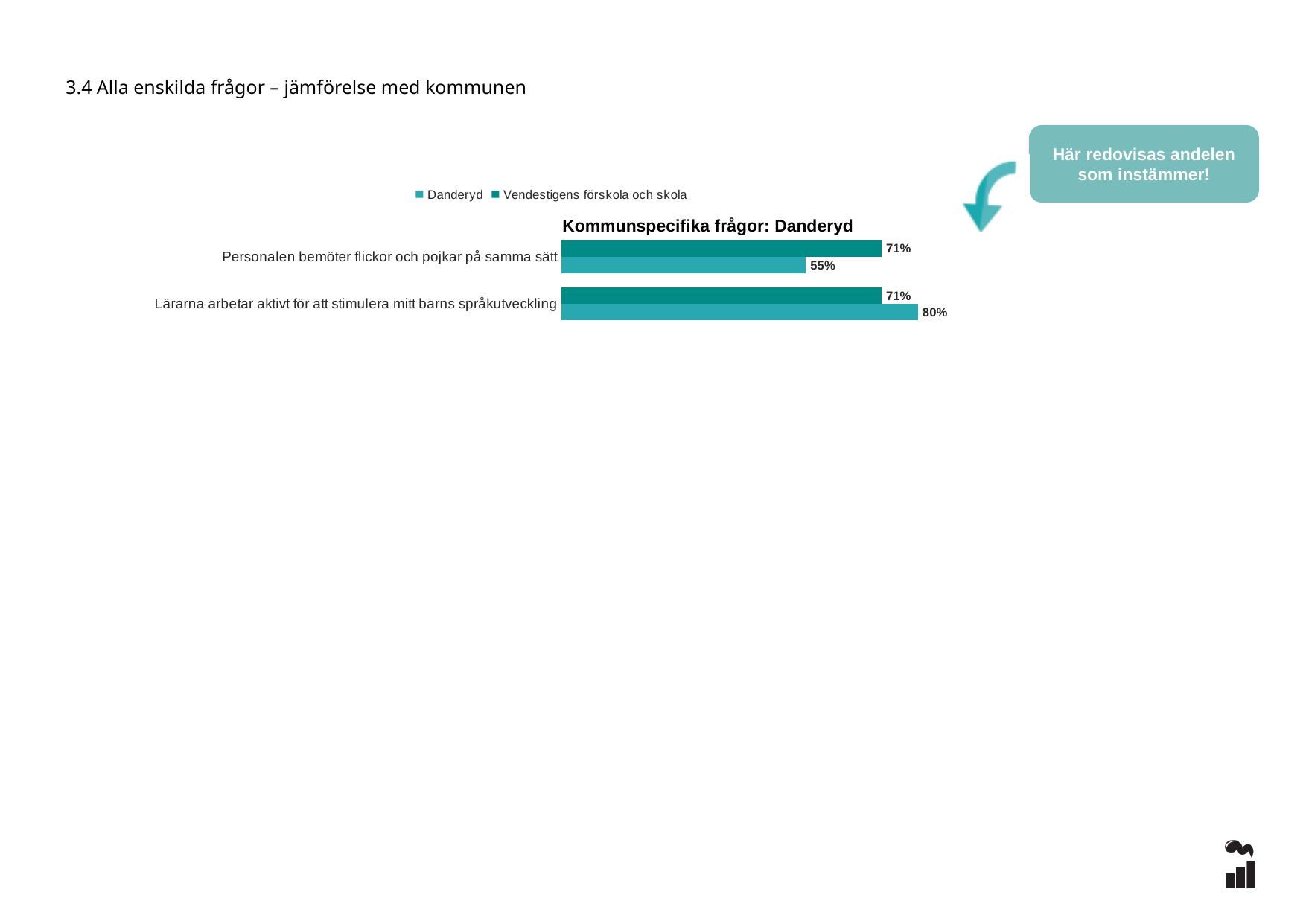
How many series does the legend list? 2 What is the value for Vendestigens förskola och skola for 'Personalen bemöter flickor och pojkar på samma sätt'? 71% What is the value for Danderyd for 'Lärarna arbetar aktivt för att stimulera mitt barns språkutveckling'? 80% What is the value for Danderyd for 'Personalen bemöter flickor och pojkar på samma sätt'? 55% For 'Lärarna arbetar aktivt för att stimulera mitt barns språkutveckling', which is larger: Danderyd or Vendestigens förskola och skola? Danderyd What is the title of the chart? Kommunspecifika frågor: Danderyd What is the difference between Vendestigens förskola och skola and Danderyd for 'Personalen bemöter flickor och pojkar på samma sätt'? 16% Which category has the lowest value for Danderyd? Personalen bemöter flickor och pojkar på samma sätt What kind of chart is shown on the slide? bar chart What is the value for Vendestigens förskola och skola for 'Lärarna arbetar aktivt för att stimulera mitt barns språkutveckling'? 71% What is the difference between Danderyd and Vendestigens förskola och skola for 'Lärarna arbetar aktivt för att stimulera mitt barns språkutveckling'? 9% How many categories (questions) are shown in the chart? 2